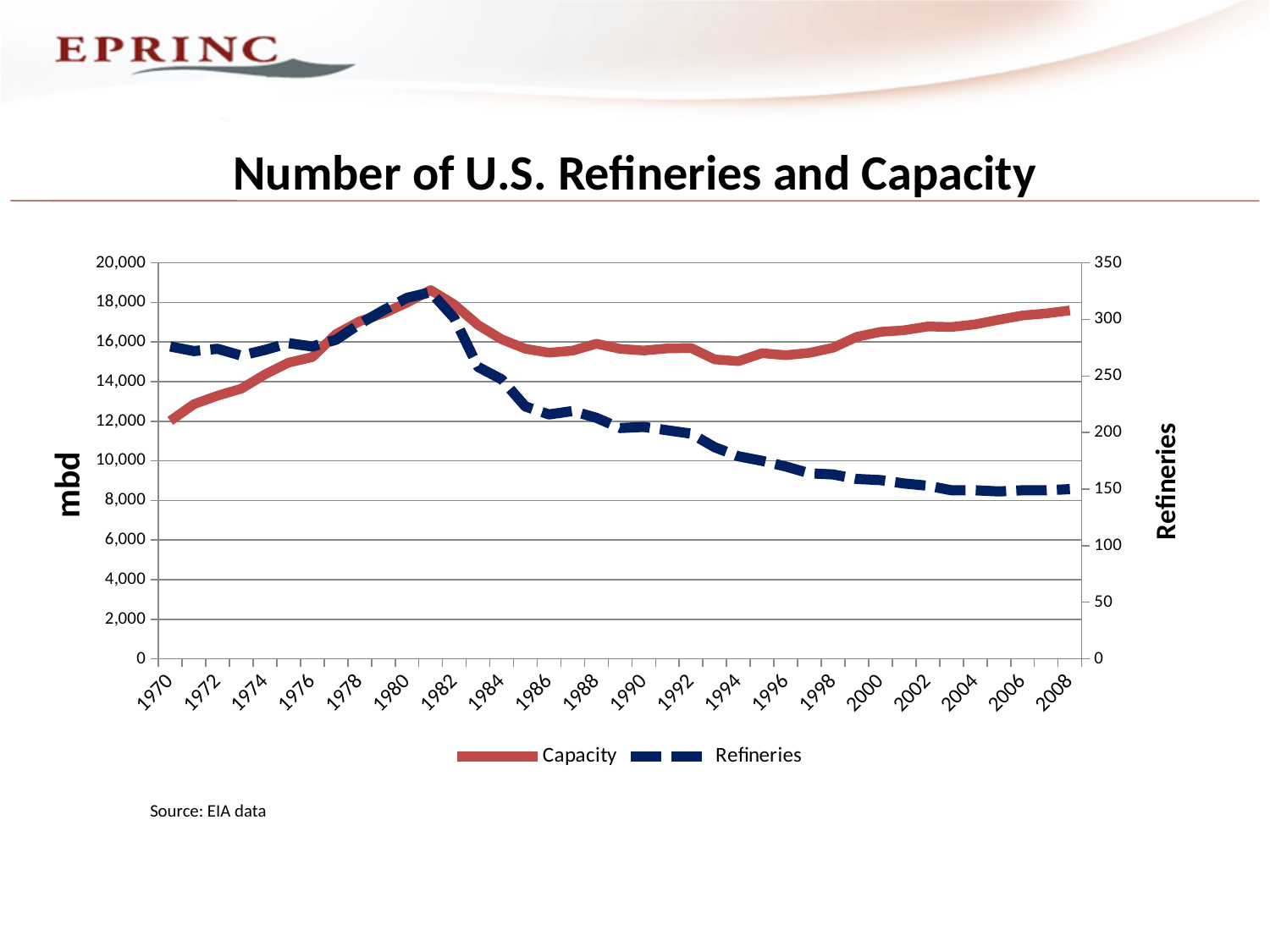
Is the Capacity value for 1970 greater or less than 14,000? less Does the Capacity series rise or fall between 1970 and 1980? rise Is the Refineries value for 2008 greater or less than 200? less What is the label on the left vertical axis? mbd What is the title of the chart? Number of U.S. Refineries and Capacity What kind of chart is shown on the slide? line chart How many series does the legend list? 2 Which is larger, the Capacity value in 1970 or in 2008? 2008 Does the Refineries series rise or fall between 1982 and 2008? fall Which is larger, the Refineries value in 1970 or in 2008? 1970 Is the Refineries value for 1970 greater or less than 250? greater